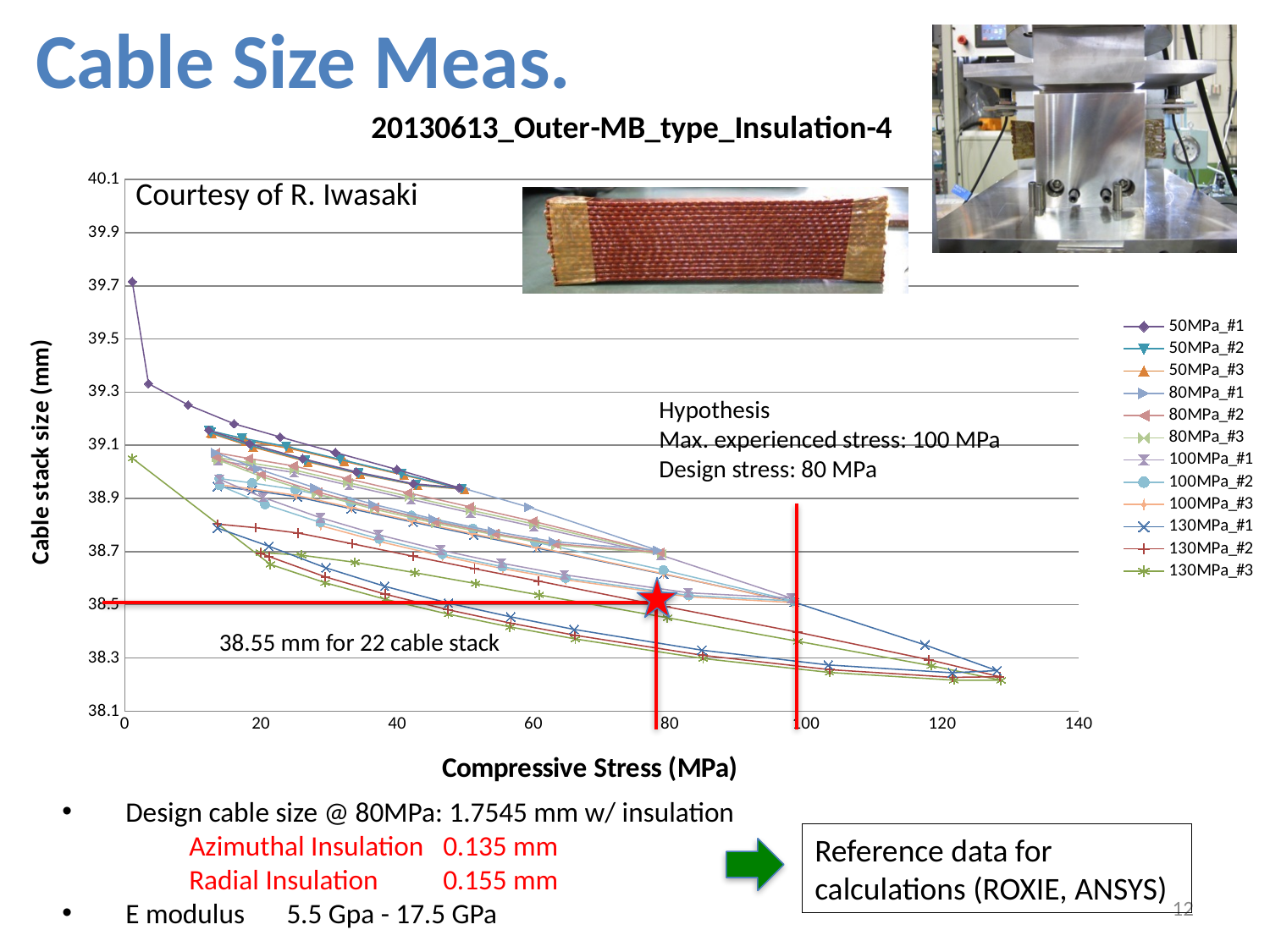
Is the cable stack size of the 130MPa_#1 series at its highest stress (around 130 MPa) greater or less than 38.3 mm? less Which group of series reaches the highest compressive stress on the x axis: the 50MPa series or the 130MPa series? 130MPa series According to the hypothesis text on the chart, what is the design stress? 80 MPa What is the label of the x axis of the chart? Compressive Stress (MPa) What kind of chart is shown on the slide? line chart According to the annotation on the chart, what cable stack size corresponds to a 22 cable stack? 38.55 mm Is the first point of the 50MPa_#1 series (near 0 MPa) greater or less than 39.5 mm? greater What is the highest value shown on the x axis of the chart? 140 As compressive stress increases along the x axis, does the cable stack size rise or fall? fall How many series does the chart legend list? 12 What is the title of the chart? 20130613_Outer-MB_type_Insulation-4 Is the cable stack size of the 130MPa_#3 series at about 20 MPa greater or less than 38.9 mm? less